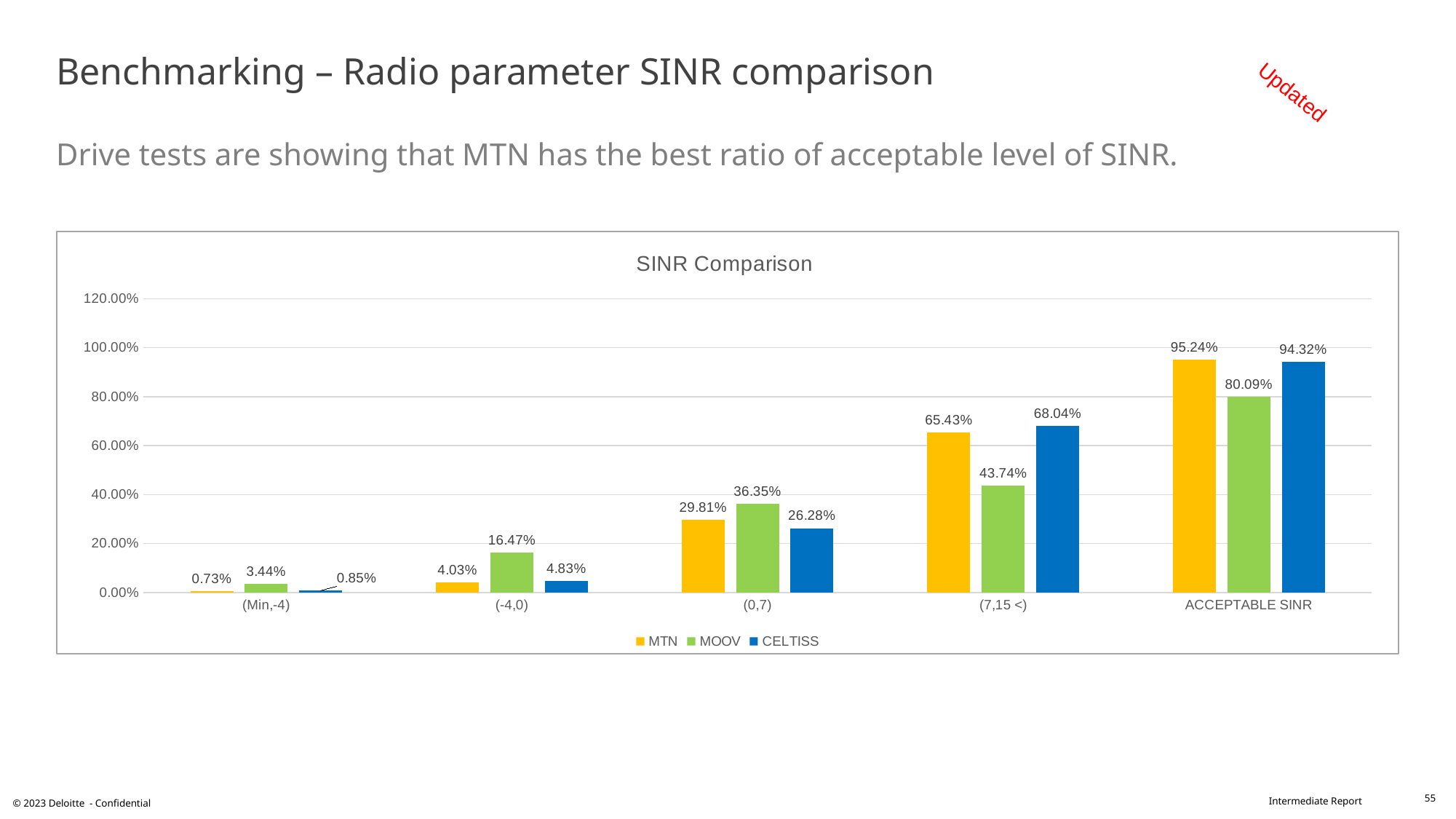
Which is larger in the (0,7) category, MTN or MOOV? MOOV What is the title of the chart? SINR Comparison How many series does the legend list? 3 Which series has the lowest value in the ACCEPTABLE SINR category? MOOV What kind of chart is shown on the slide? Bar chart What is the value for CELTISS in the (0,7) category? 26.28% How many categories are shown on the x axis? 5 Which series has the highest value in the (7,15 <) category? CELTISS What is the difference between MTN and MOOV in the ACCEPTABLE SINR category? 15.15% Do the MTN values rise or fall from (Min,-4) to ACCEPTABLE SINR? Rise What is the value for MOOV in the (-4,0) category? 16.47% What is the value for MTN in the ACCEPTABLE SINR category? 95.24%